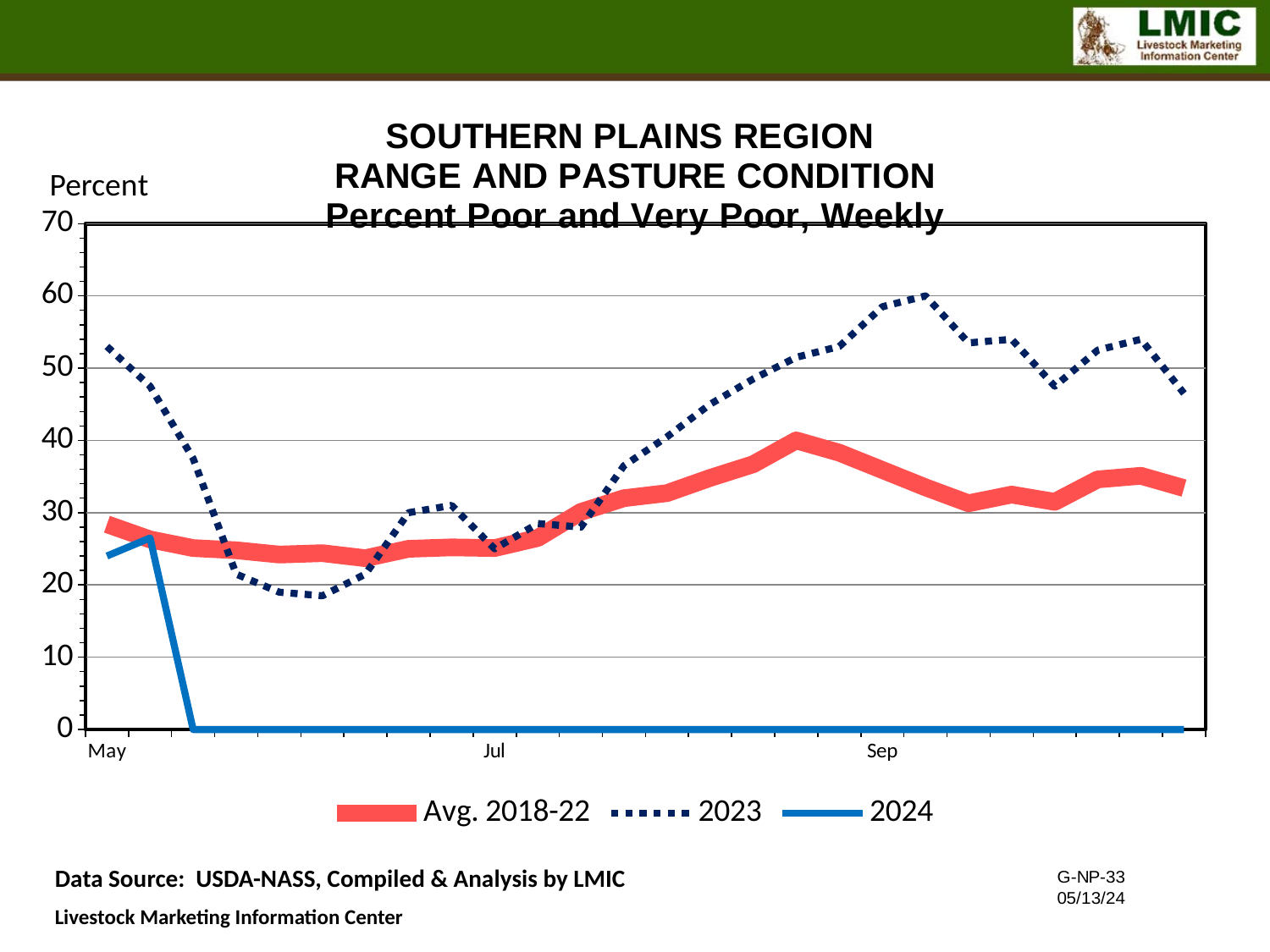
Does the 2023 series rise or fall between Jul and Sep? rise Is the value for the 2023 series at the start of May greater or less than 50? greater What is the label on the vertical axis of the chart? Percent Around Sep, which series has the higher value: 2023 or Avg. 2018-22? 2023 What type of chart is shown on the slide? Line chart How many series does the legend list? 3 Is the lowest value of the 2023 series (in early June) greater or less than 20? less Is the value for the 2024 series at the start of May greater or less than 20? greater Which series is drawn as a dotted line in the chart? 2023 Which series reaches the highest value anywhere on the chart? 2023 At the start of May, which series has the higher value: 2023 or Avg. 2018-22? 2023